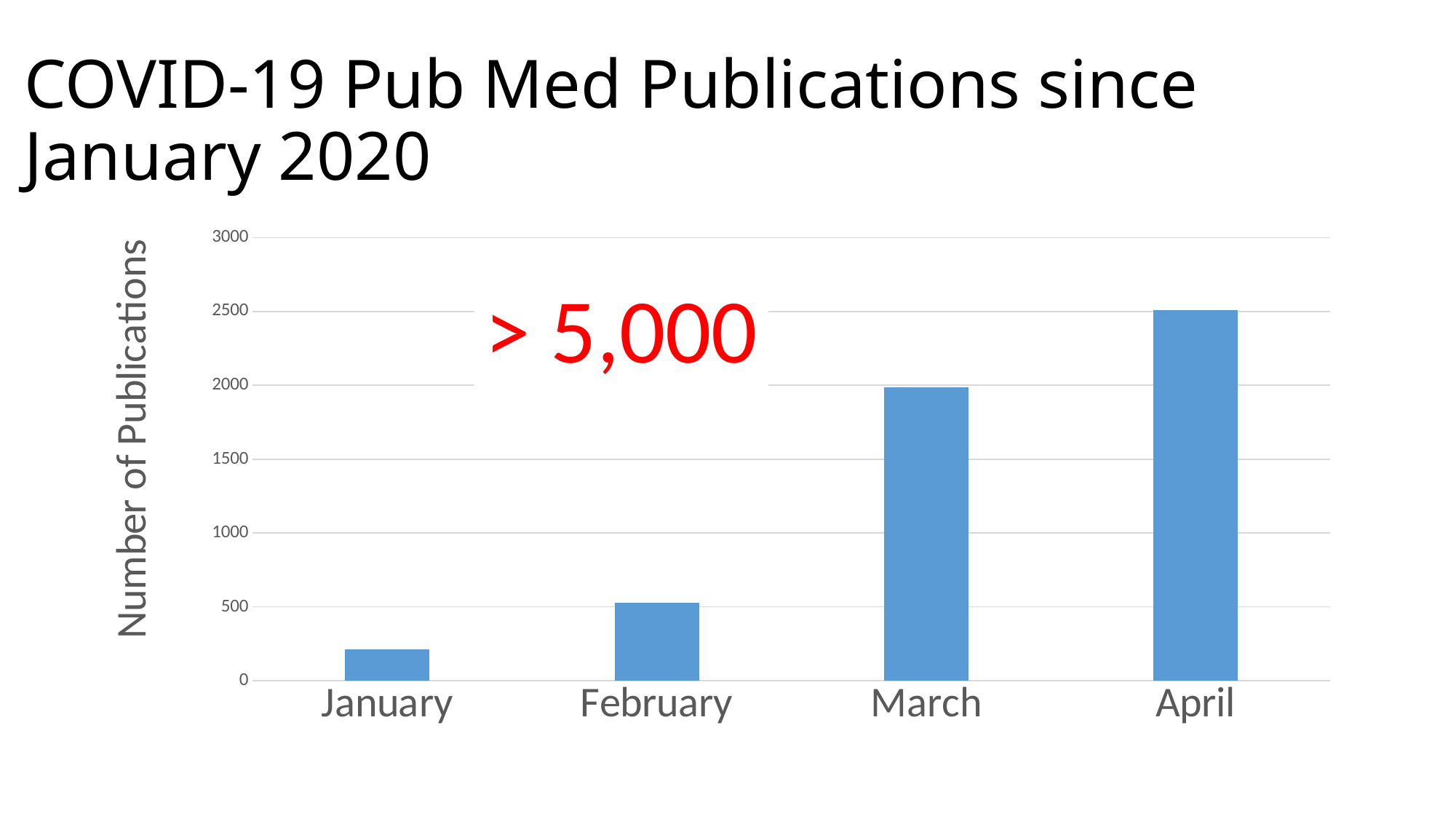
Is the value for March greater or less than 1500? greater What kind of chart is shown on the slide? bar chart What is the label on the vertical axis of the chart? Number of Publications Is the value for February greater or less than 1000? less Which month has the highest number of publications? April Is the value for April greater or less than 2000? greater Do the number of publications rise or fall from January to April? rise Which month has more publications, February or March? March Which month has the lowest number of publications? January What red annotation is written over the chart? > 5,000 How many months are shown on the x axis of the chart? 4